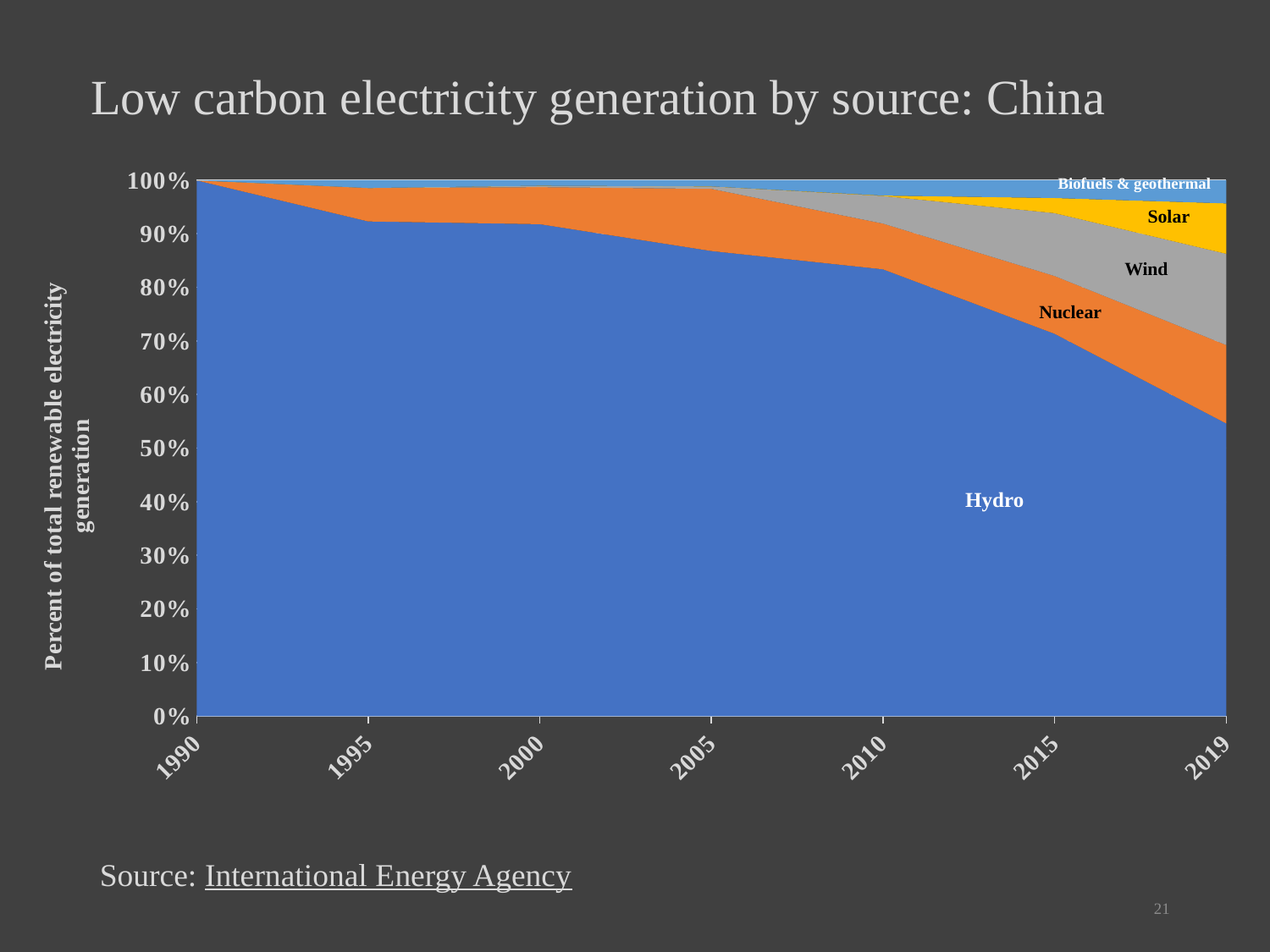
Which source accounts for the largest share of renewable electricity generation in 2019? Hydro Which is larger in 2019, the share of Hydro or the share of Nuclear? Hydro What is the title of the chart? Low carbon electricity generation by source: China What is the label on the vertical axis of the chart? Percent of total renewable electricity generation Is the share of Hydro in 2010 greater or less than 70%? greater What kind of chart is shown on the slide? Stacked area chart Is the share of Hydro in 2015 greater or less than 80%? less How many year labels are shown on the horizontal axis? 7 Is the share of Hydro in 2019 greater or less than 60%? less Does the share of Hydro rise or fall between 1990 and 2019? Fall How many electricity sources are labelled on the chart? 5